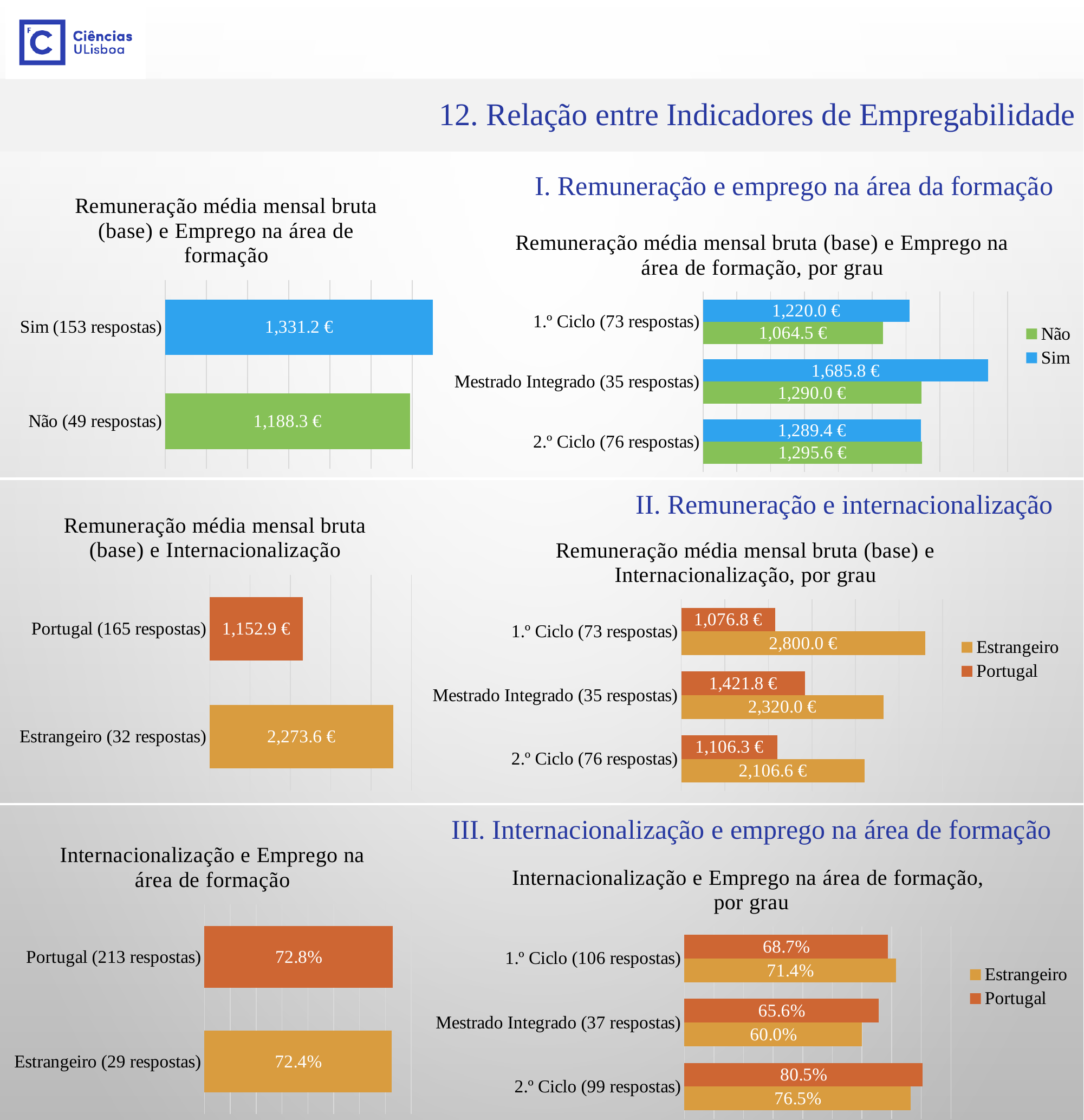
What kind of chart is the bottom-right chart 'Internacionalização e Emprego na área de formação, por grau'? Bar chart In the middle-right chart 'Remuneração média mensal bruta (base) e Internacionalização, por grau', what is the 'Estrangeiro' value for '1.º Ciclo (73 respostas)'? 2,800.0 € In the top-right chart 'Remuneração média mensal bruta (base) e Emprego na área de formação, por grau', which degree has the lowest 'Não' value? 1.º Ciclo (73 respostas) In the top-right chart 'Remuneração média mensal bruta (base) e Emprego na área de formação, por grau', how many series does the legend list? 2 In the middle-left chart 'Remuneração média mensal bruta (base) e Internacionalização', which category has the higher value, Portugal or Estrangeiro? Estrangeiro (32 respostas) In the top-left chart 'Remuneração média mensal bruta (base) e Emprego na área de formação', what is the difference between the 'Sim' and 'Não' values? 142.9 € In the middle-right chart 'Remuneração média mensal bruta (base) e Internacionalização, por grau', what is the difference between the 'Estrangeiro' and 'Portugal' values for 'Mestrado Integrado (35 respostas)'? 898.2 € In the bottom-right chart 'Internacionalização e Emprego na área de formação, por grau', which degree has the highest 'Portugal' value? 2.º Ciclo (99 respostas) In the top-left chart 'Remuneração média mensal bruta (base) e Emprego na área de formação', what is the value for 'Sim (153 respostas)'? 1,331.2 € In the top-right chart 'Remuneração média mensal bruta (base) e Emprego na área de formação, por grau', what is the 'Sim' value for 'Mestrado Integrado (35 respostas)'? 1,685.8 € In the middle-left chart 'Remuneração média mensal bruta (base) e Internacionalização', what is the value for 'Estrangeiro (32 respostas)'? 2,273.6 € In the bottom-left chart 'Internacionalização e Emprego na área de formação', what is the value for 'Portugal (213 respostas)'? 72.8%